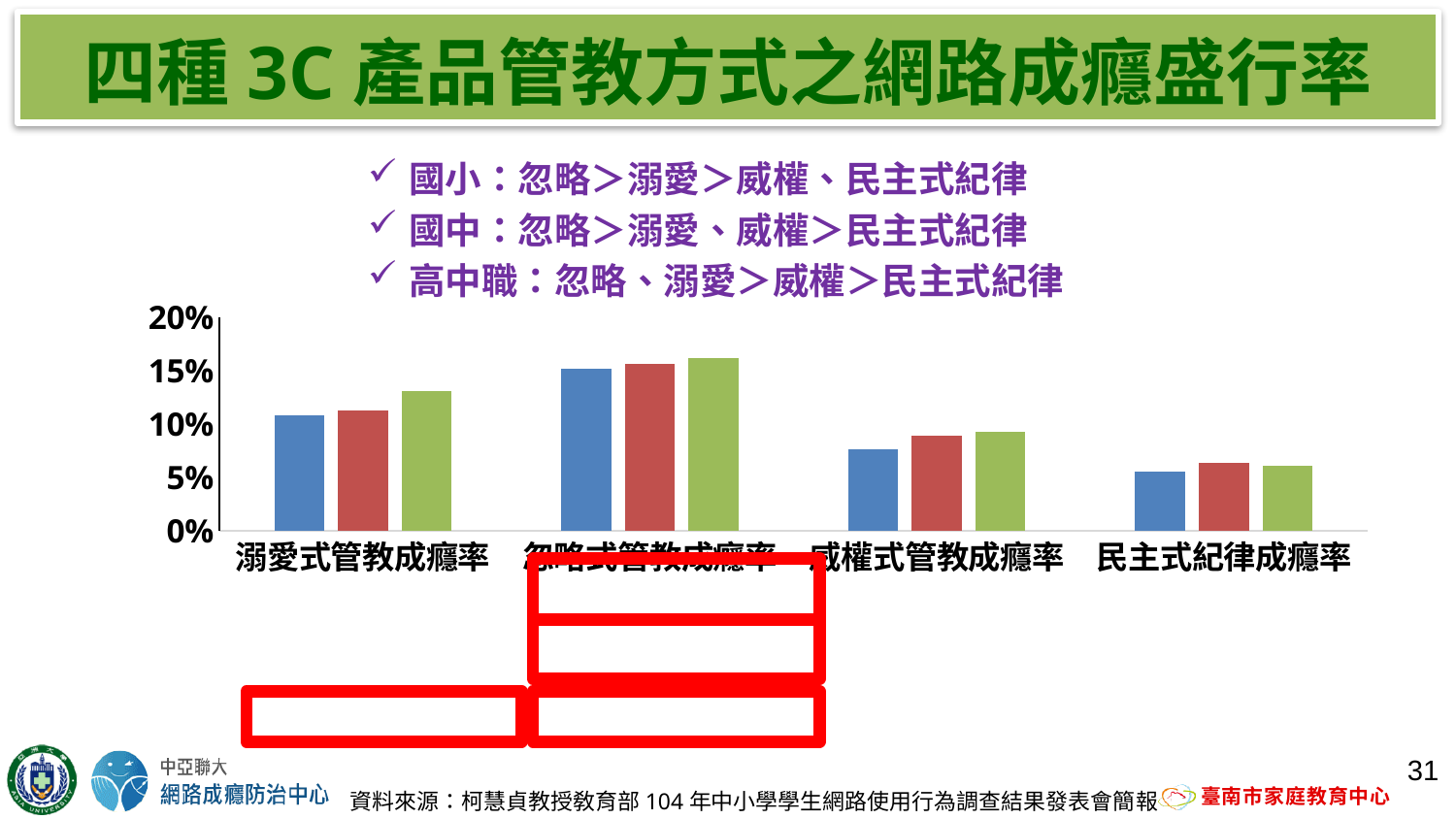
What is the highest value shown on the y axis of the chart? 20% Is the value of the green bar for 忽略式管教成癮率 greater or less than 15%? greater Is the value of the red bar for 威權式管教成癮率 greater or less than 10%? less Which category has a larger blue bar, 溺愛式管教成癮率 or 威權式管教成癮率? 溺愛式管教成癮率 What is the title of the slide containing the chart? 四種 3C 產品管教方式之網路成癮盛行率 Which category has the highest bars in the chart? 忽略式管教成癮率 Is the value of the blue bar for 溺愛式管教成癮率 greater or less than 10%? greater How many bars are plotted for each category in the chart? 3 Which category has the lowest bars in the chart? 民主式紀律成癮率 What kind of chart is shown on the slide? bar chart How many categories are shown on the x axis of the chart? 4